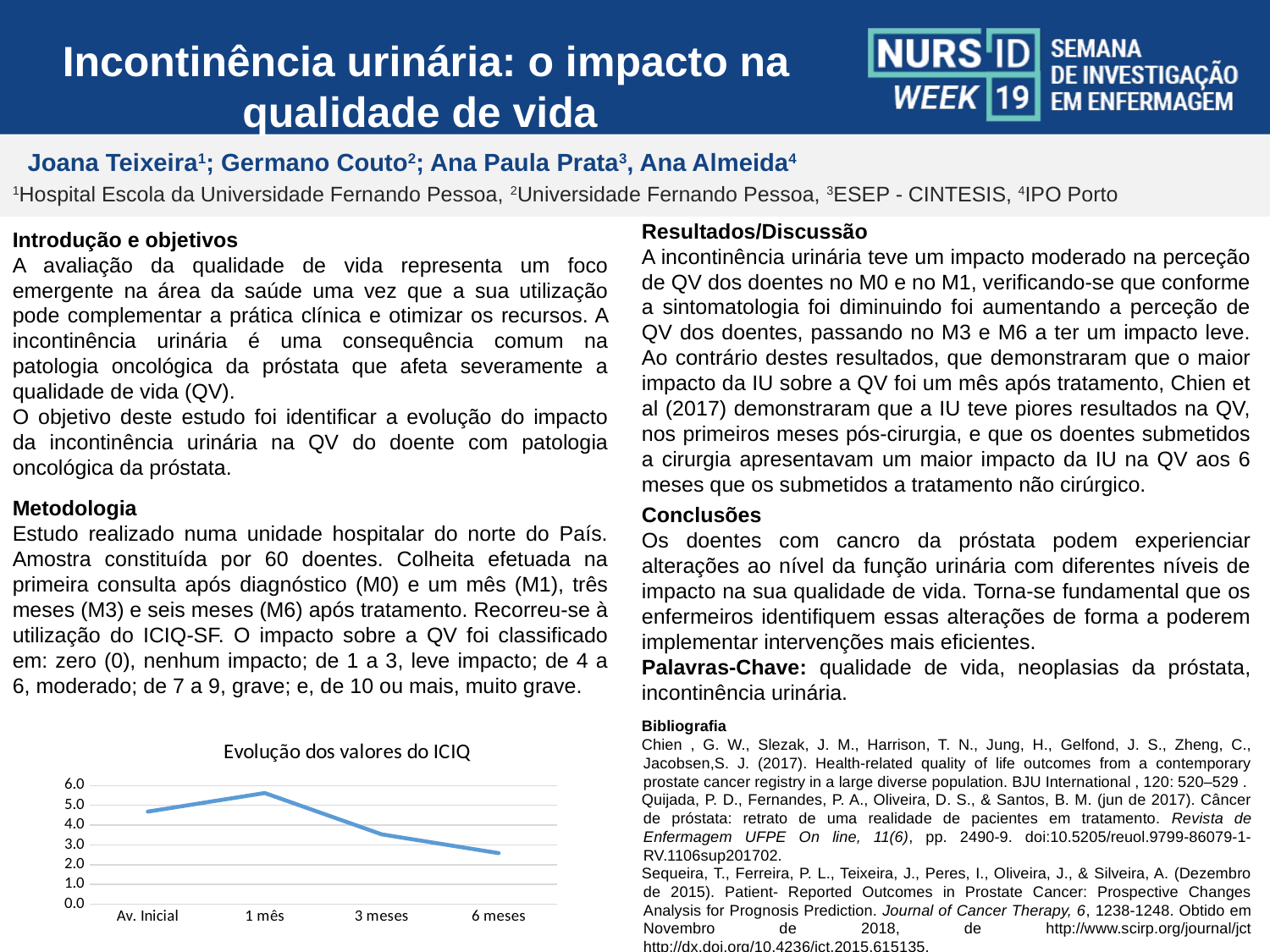
Which category has the lowest value in the chart? 6 meses Is the value for 6 meses greater or less than 3.0? less How many points are plotted along the x axis of the chart? 4 What kind of chart is shown on the slide? line chart What is the title of the chart on the slide? Evolução dos valores do ICIQ Is the value for 3 meses greater or less than 4.0? less Do the values rise or fall from 1 mês to 6 meses? fall Is the value for 1 mês greater or less than 5.0? greater What is the highest tick value shown on the y axis of the chart? 6.0 Which category has the highest value in the chart? 1 mês Which is larger, the value for Av. Inicial or the value for 3 meses? Av. Inicial